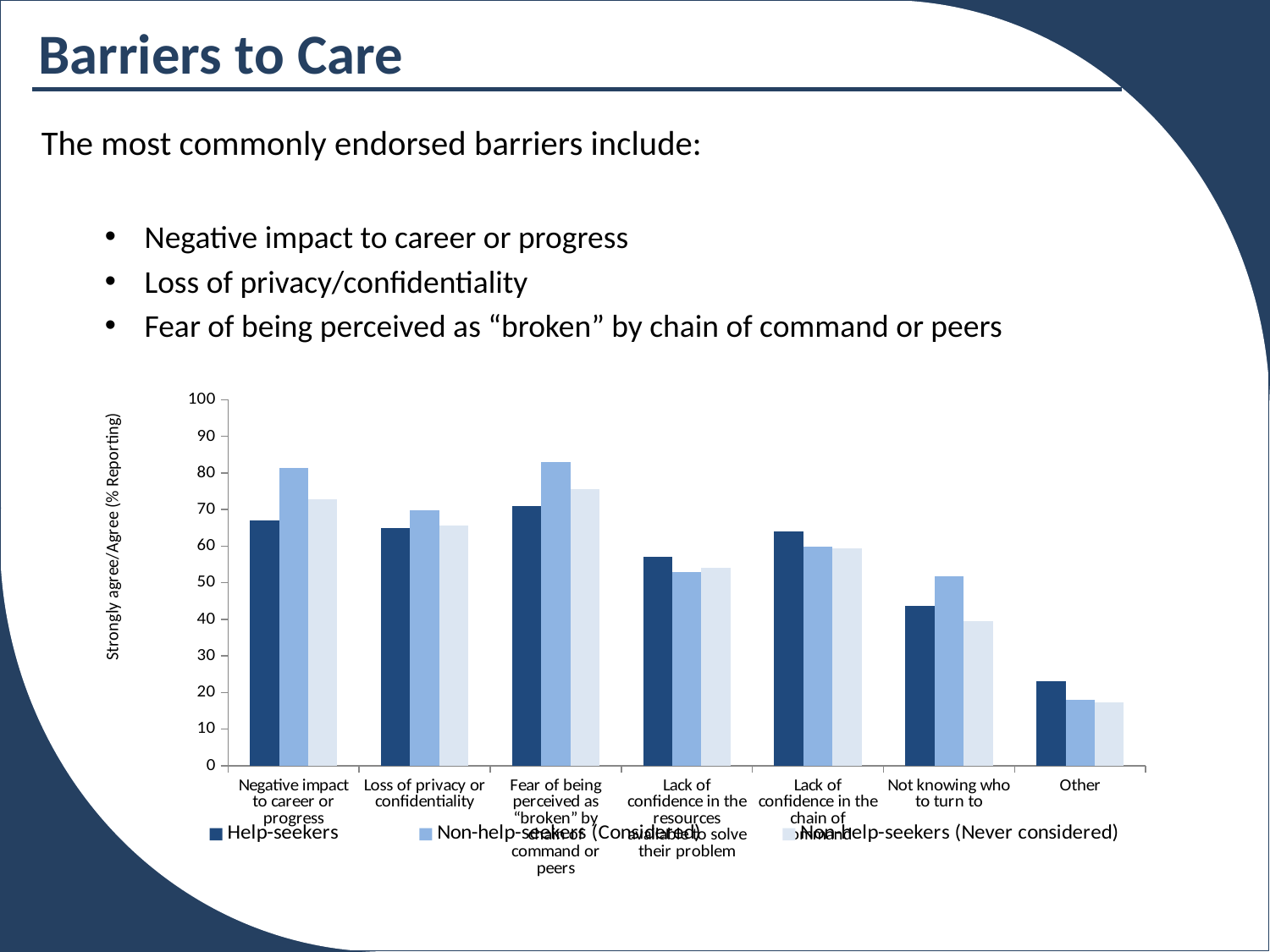
How many barrier categories are shown on the x axis of the chart? 7 Which category has the lowest value for Non-help-seekers (Considered)? Other How many series does the chart's legend list? 3 Which category has the highest value for Help-seekers? Fear of being perceived as "broken" by chain of command or peers Is the Non-help-seekers (Considered) value for Negative impact to career or progress greater or less than 70? greater For Negative impact to career or progress, which is larger: Help-seekers or Non-help-seekers (Considered)? Non-help-seekers (Considered) Is the Help-seekers value for Negative impact to career or progress greater or less than 60? greater Is the Help-seekers value for Other greater or less than 30? less What kind of chart is shown on the slide? bar chart For Lack of confidence in the resources available to solve their problem, which is larger: Help-seekers or Non-help-seekers (Considered)? Help-seekers What is the label on the chart's vertical axis? Strongly agree/Agree (% Reporting) Which category has the lowest value for Help-seekers? Other